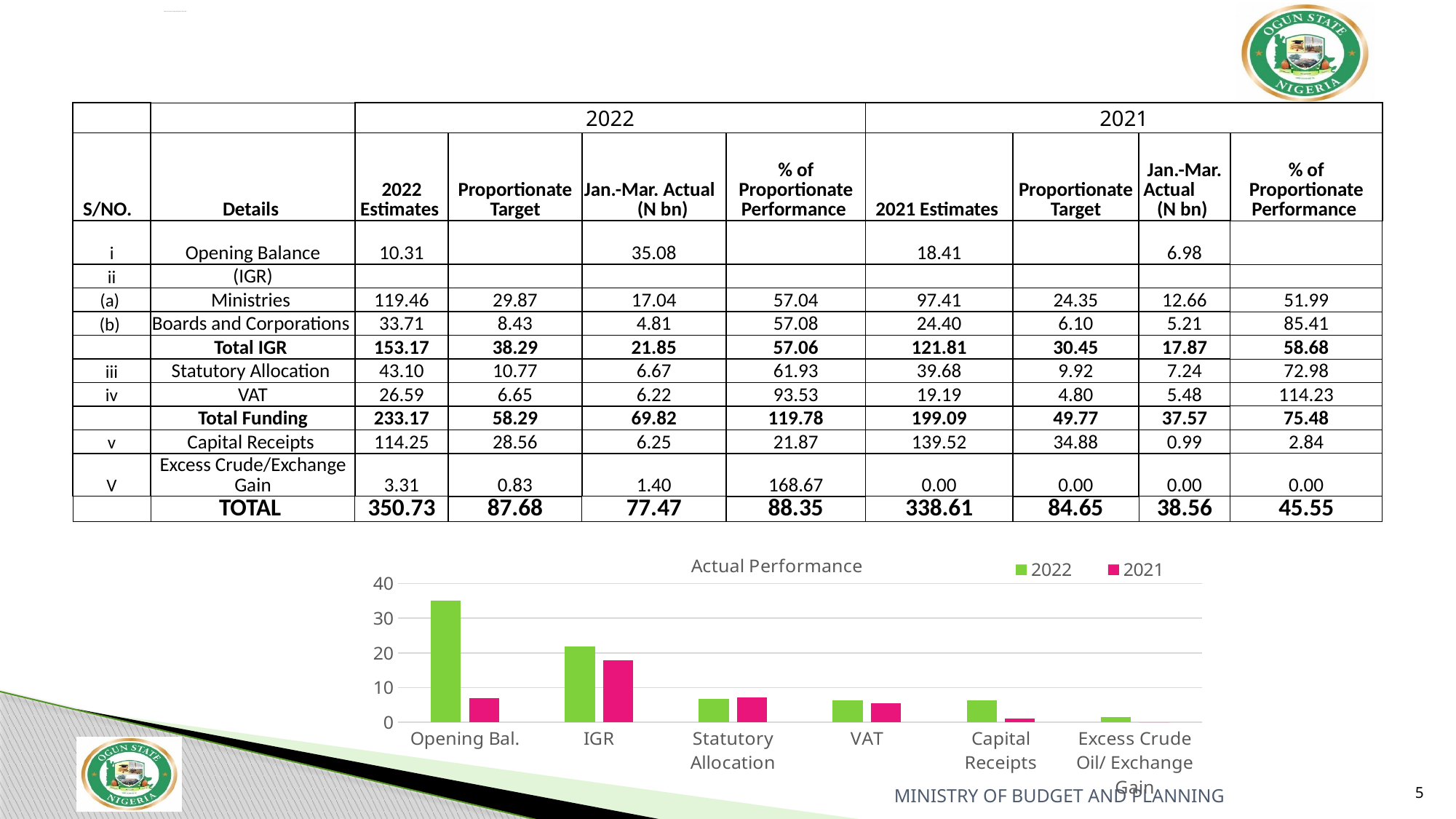
In the Actual Performance chart, which category has the highest 2021 bar? IGR What kind of chart is shown under the table on the slide? bar chart How many series does the legend of the Actual Performance chart list? 2 In the Actual Performance chart, is the 2022 value for Opening Bal. greater or less than 30? greater In the Actual Performance chart, is the 2021 value for Opening Bal. greater or less than 10? less Which colour represents the 2021 series in the Actual Performance chart? pink How many categories are shown on the x axis of the Actual Performance chart? 6 In the Actual Performance chart, which category has the lowest 2022 bar? Excess Crude Oil/ Exchange Gain In the Actual Performance chart, which category has the highest 2022 bar? Opening Bal. What is the title of the chart on the slide? Actual Performance In the Actual Performance chart, is the 2022 value for IGR greater or less than 20? greater In the Actual Performance chart, which is larger for Capital Receipts, the 2022 value or the 2021 value? 2022